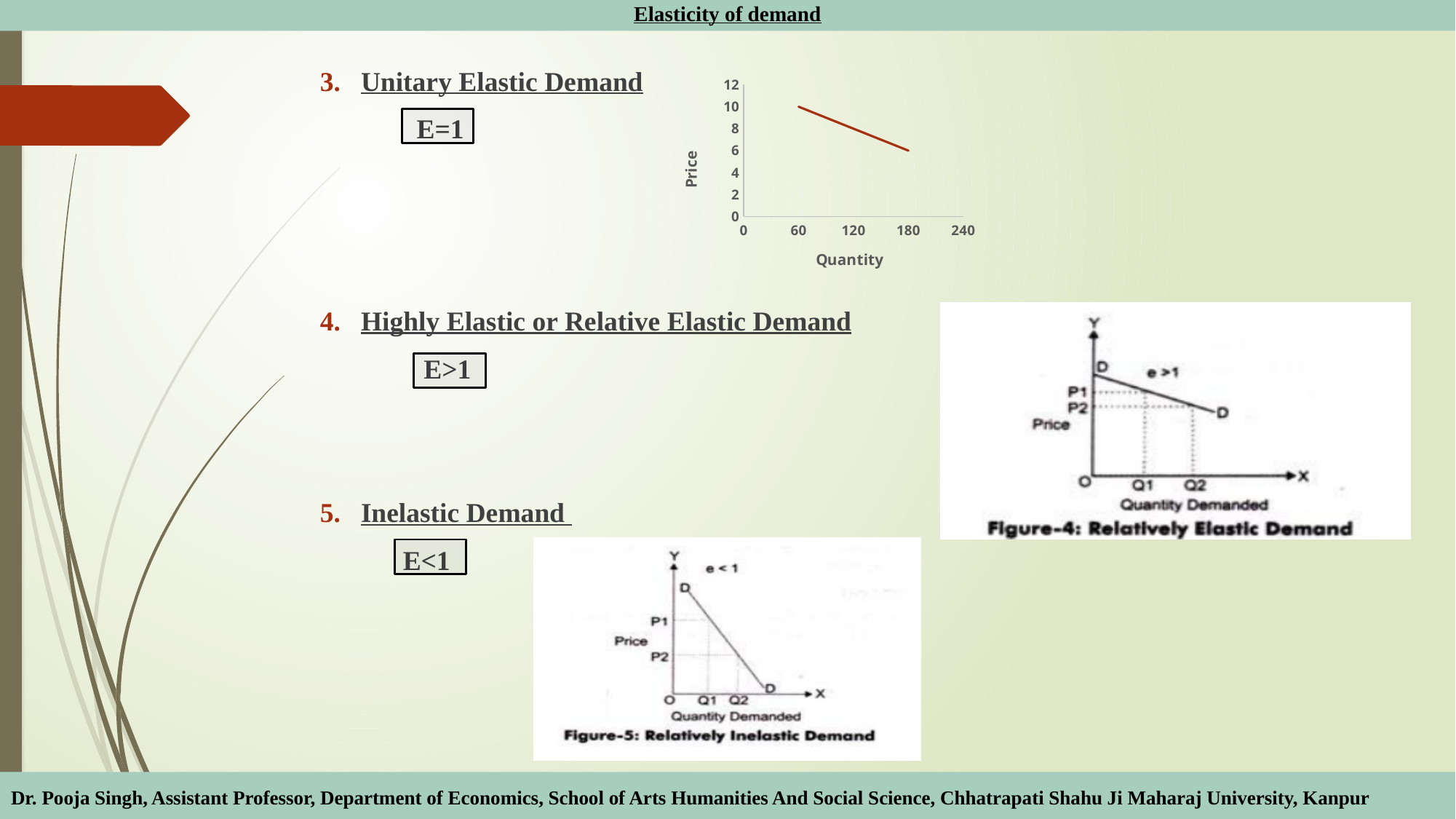
In the Price versus Quantity chart, what is the price at a quantity of 180? 6 In the Price versus Quantity chart, what is the difference between the price at quantity 60 and the price at quantity 180? 4 What kind of chart is the Price versus Quantity chart next to 'Unitary Elastic Demand'? line chart In the Price versus Quantity chart, what is the label on the vertical axis? Price In the Price versus Quantity chart, is the price at a quantity of 120 greater or less than 10? less In the Price versus Quantity chart, is the price at a quantity of 120 greater or less than 6? greater In the Price versus Quantity chart, is the price higher at a quantity of 60 or at a quantity of 180? 60 In the Price versus Quantity chart, what is the label on the horizontal axis? Quantity In the Price versus Quantity chart, how many tick labels are shown on the horizontal axis? 5 In the Price versus Quantity chart, does the line rise or fall as quantity increases? fall In the Price versus Quantity chart, what is the price at a quantity of 60? 10